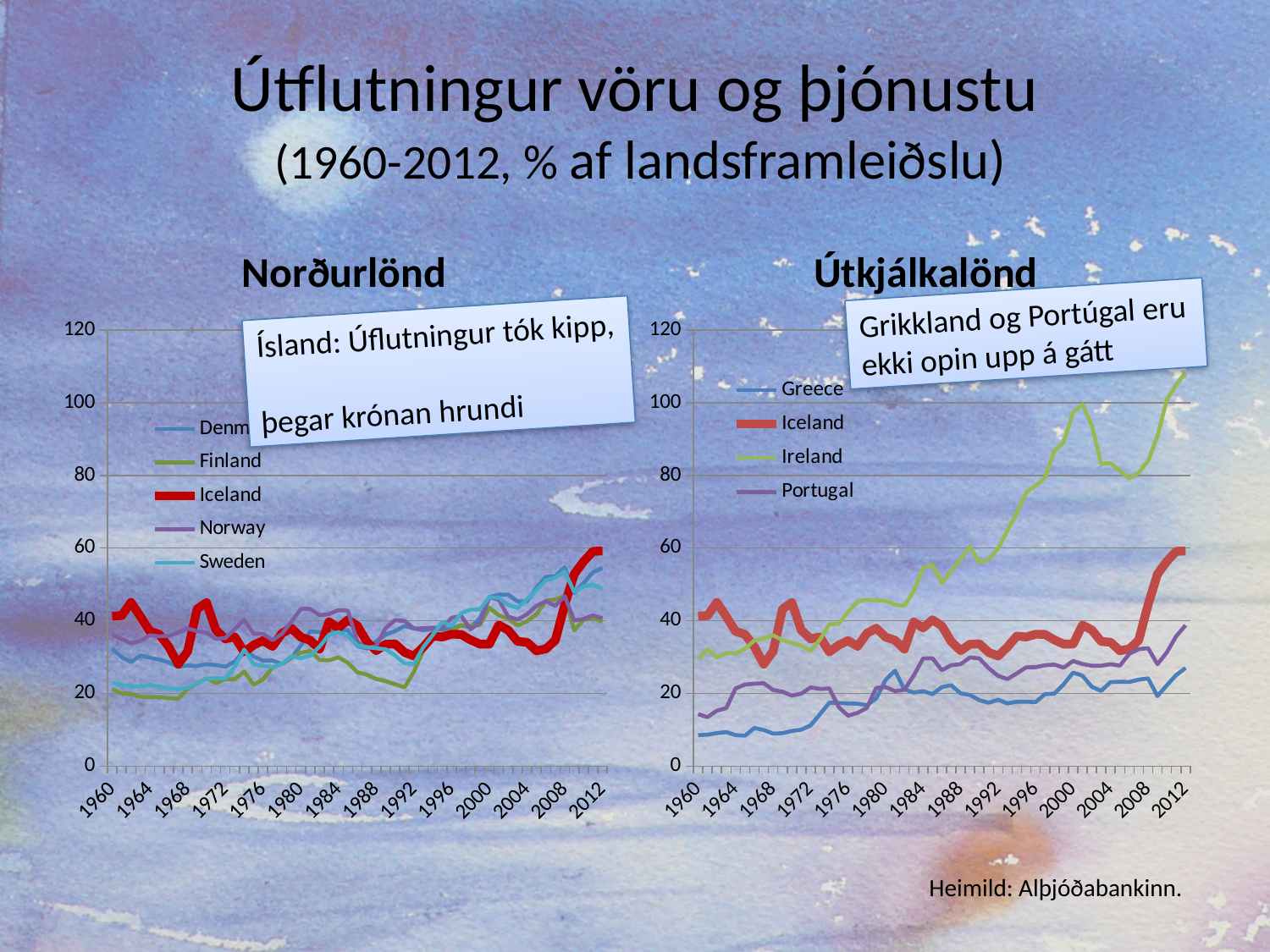
How many series does the legend of the Norðurlönd chart on the left list? 5 In the Útkjálkalönd chart on the right, is the value for Portugal in 1960 greater or less than 20? less In the Norðurlönd chart on the left, is the value for Sweden in 2008 greater or less than 40? greater In the Útkjálkalönd chart on the right, which series has the highest value in 2012? Ireland In the Útkjálkalönd chart on the right, is the value for Ireland in 2012 greater or less than 100? greater In the Útkjálkalönd chart on the right, which series has the lowest value in 2012? Greece What is the title of the chart on the right? Útkjálkalönd In the Útkjálkalönd chart on the right, does the Ireland series overall rise or fall from 1960 to 2012? rise What kind of chart is the Norðurlönd chart on the left? line chart How many series does the legend of the Útkjálkalönd chart on the right list? 4